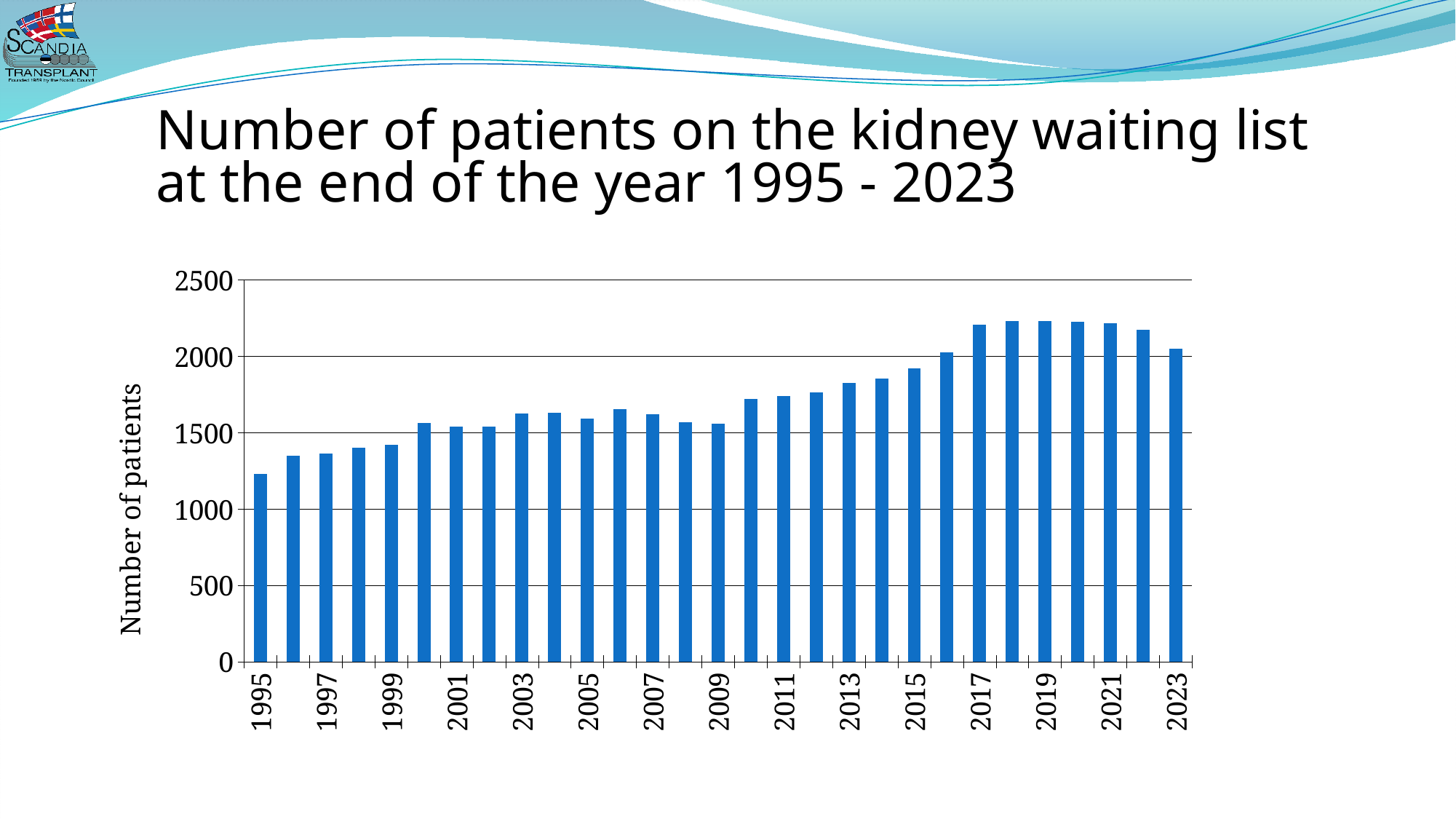
Which is larger, the value for 2019 or the value for 2009? 2019 Which year has the lowest number of patients on the kidney waiting list? 1995 What is the highest value shown on the vertical axis? 2500 What is the label on the vertical axis? Number of patients Is the value for 2015 greater or less than 2000? less Is the value for 2017 greater or less than 2000? greater Is the value for 1999 greater or less than 1500? less What kind of chart is shown on the slide? bar chart Overall, do the values rise or fall from 1995 to 2019? rise